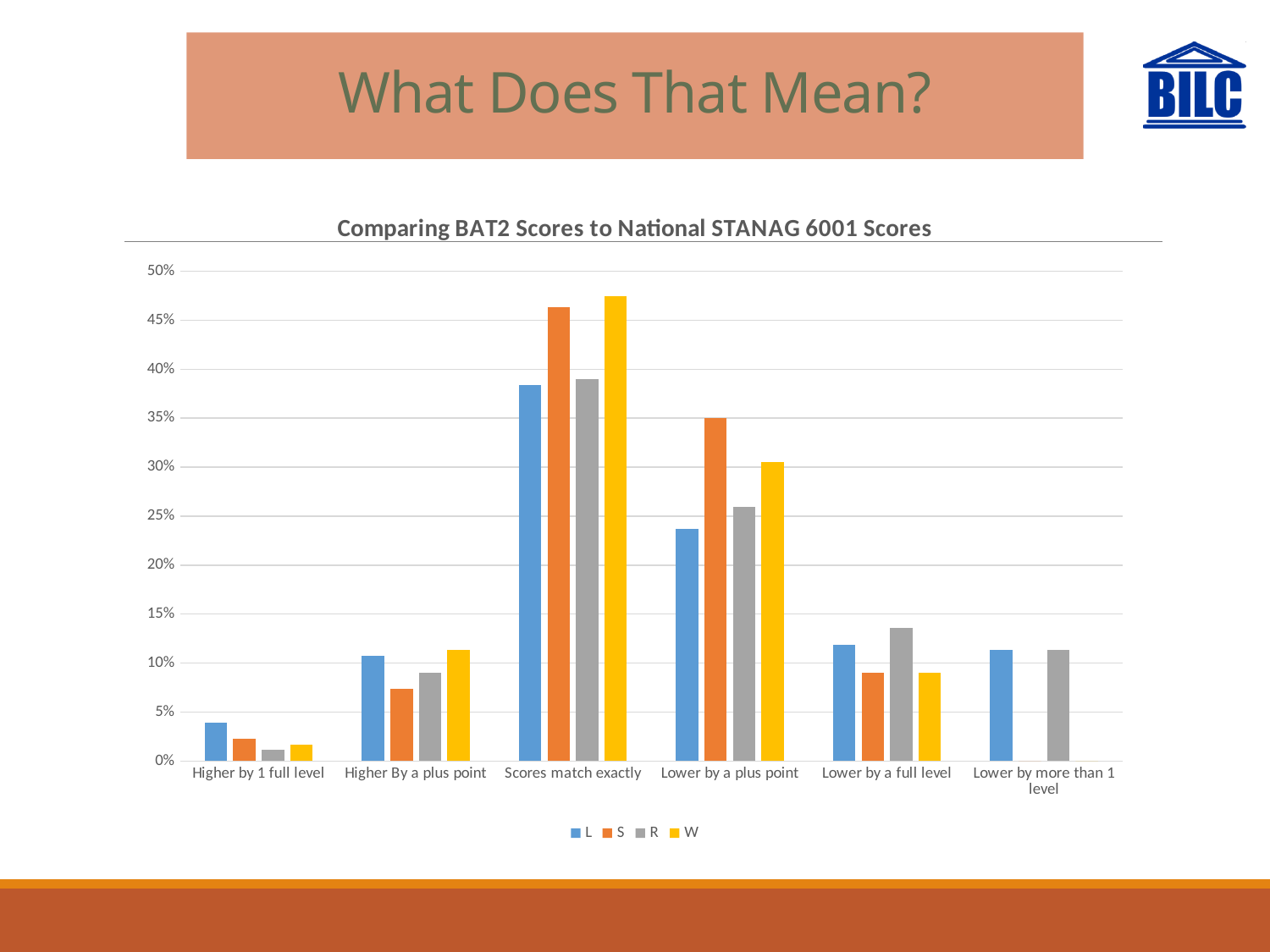
Which series has the lowest value in the 'Higher by 1 full level' category? R For which category is the W series highest? Scores match exactly How many series does the legend list? 4 Is the value for W in the 'Scores match exactly' category greater or less than 45%? greater In the 'Lower by a plus point' category, which is larger, the S value or the L value? S Is the value for S in the 'Higher by 1 full level' category greater or less than 5%? less What is the title of the chart? Comparing BAT2 Scores to National STANAG 6001 Scores Is the value for L in the 'Lower by a plus point' category greater or less than 20%? greater What kind of chart is shown on the slide? bar chart How many categories are shown along the x axis? 6 In the 'Scores match exactly' category, which is larger, the S value or the R value? S